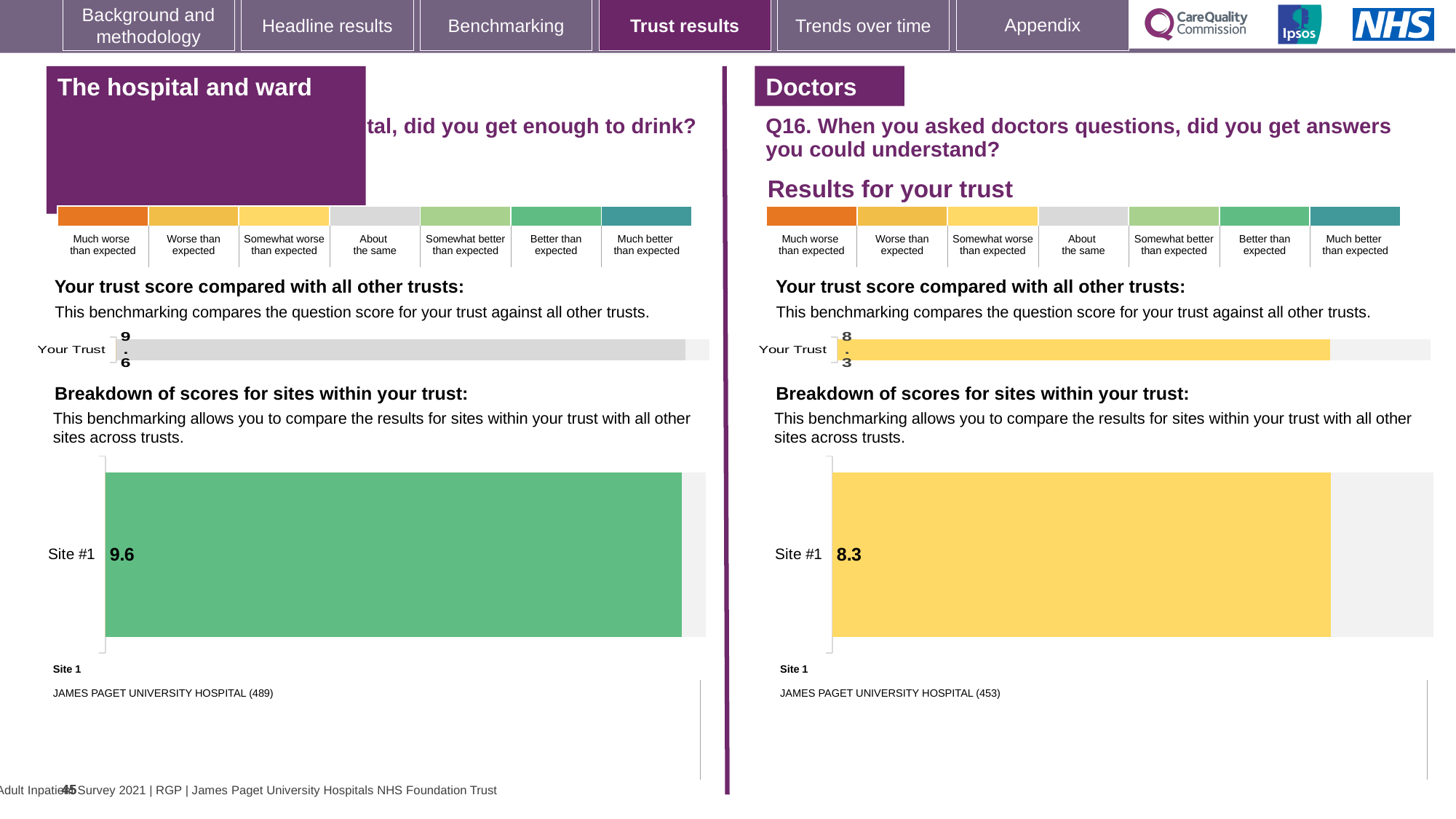
What type of chart is used to show the Site #1 score under 'Doctors'? Bar chart In the 'Your trust score compared with all other trusts' chart under 'Doctors' (right side), what is the value for Your Trust? 8.3 How many sites are plotted in the 'Breakdown of scores for sites within your trust' chart under 'Doctors'? 1 What type of chart is used for 'Your trust score compared with all other trusts' on the left side of the slide? Bar chart In the 'Your trust score compared with all other trusts' chart on the left side of the slide, what is the value for Your Trust? 9.6 Comparing the Site #1 bars, which is larger: the one in the left-hand 'The hospital and ward' breakdown chart or the one in the right-hand 'Doctors' breakdown chart? The hospital and ward (left) In the 'Breakdown of scores for sites within your trust' chart under 'The hospital and ward' (left side), what is the score for Site #1? 9.6 How many sites are plotted in the 'Breakdown of scores for sites within your trust' chart on the left side of the slide? 1 According to the colour key, which benchmark category does the colour of the Site #1 bar in the left-hand 'The hospital and ward' breakdown chart correspond to? Better than expected In the 'Breakdown of scores for sites within your trust' chart under 'Doctors' (right side), what is the score for Site #1? 8.3 What is the difference between the Site #1 score in the left-hand breakdown chart (9.6) and the Site #1 score in the right-hand 'Doctors' breakdown chart (8.3)? 1.3 According to the colour key, which benchmark category does the colour of the Site #1 bar in the 'Doctors' breakdown chart correspond to? Somewhat worse than expected